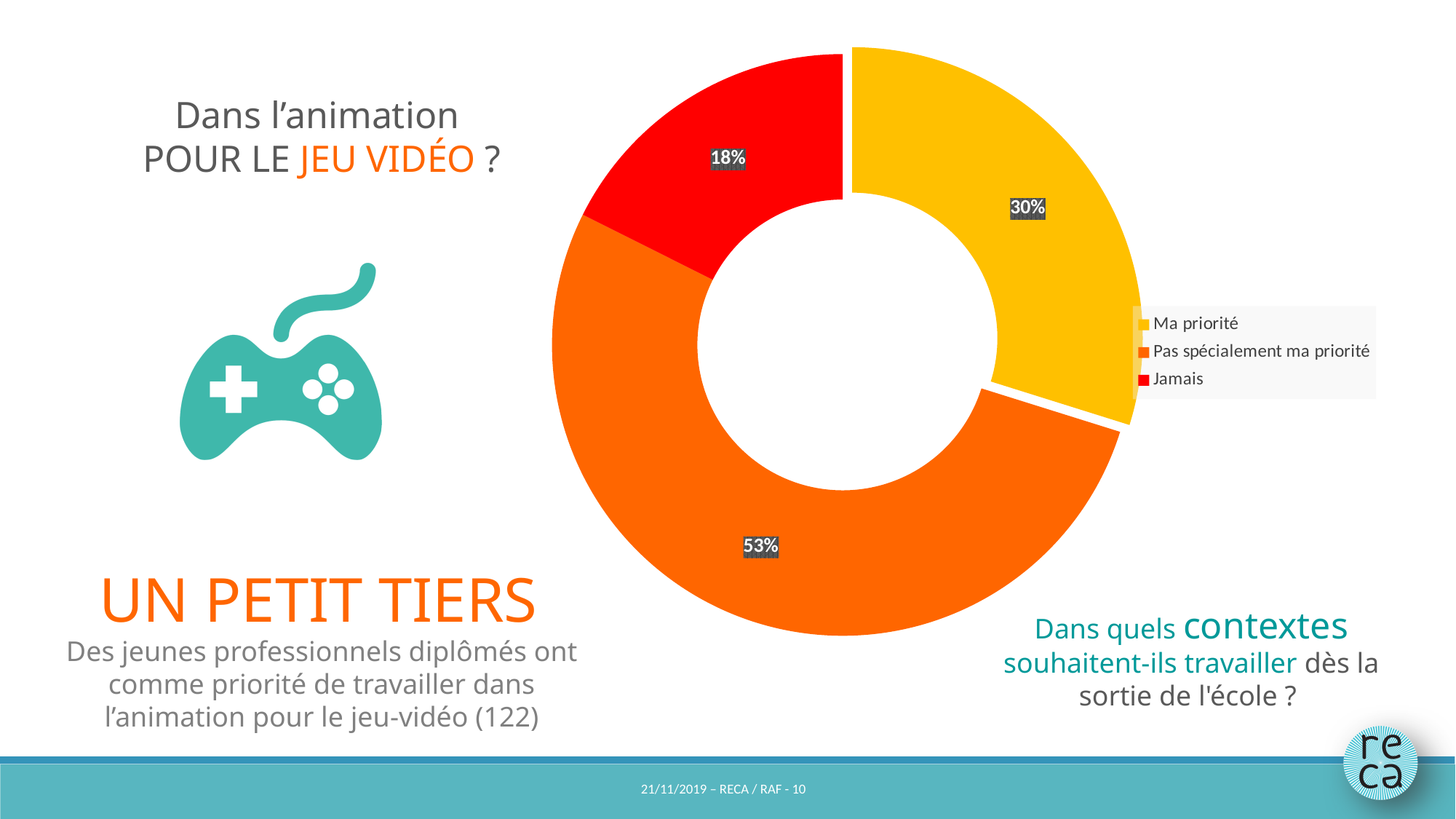
Which is larger, the share for "Ma priorité" or the share for "Jamais"? Ma priorité What percentage of respondents answered "Jamais"? 18% Which legend entry is shown in yellow? Ma priorité What is the difference in percentage points between "Pas spécialement ma priorité" and "Ma priorité"? 23 What kind of chart is shown on the slide? Pie chart (doughnut) What percentage of respondents answered "Pas spécialement ma priorité"? 53% What colour is the "Jamais" slice? Red Which category has the largest share of the pie? Pas spécialement ma priorité What is the difference in percentage points between "Ma priorité" and "Jamais"? 12 How many categories does the pie chart show? 3 Which category has the smallest share of the pie? Jamais What percentage of respondents answered "Ma priorité"? 30%